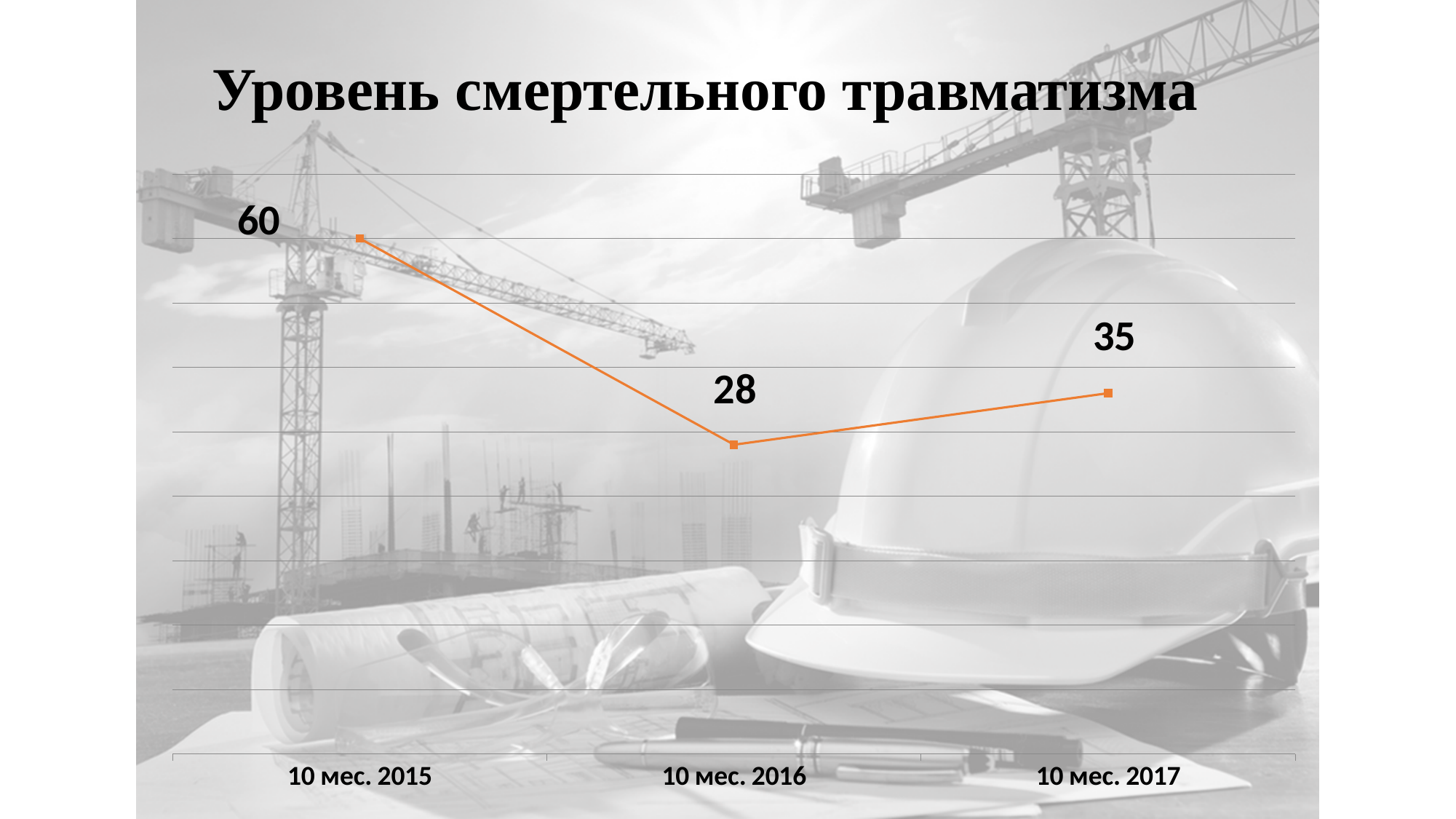
Which is larger, the value for 10 мес. 2016 or 10 мес. 2017? 10 мес. 2017 Does the value rise or fall from 10 мес. 2015 to 10 мес. 2016? fall What is the value for 10 мес. 2015? 60 What kind of chart is shown on the slide? line chart How many data points are plotted on the chart? 3 What is the title of the chart? Уровень смертельного травматизма What is the value for 10 мес. 2017? 35 Which period has the lowest value? 10 мес. 2016 What is the difference between the values for 10 мес. 2015 and 10 мес. 2016? 32 What is the difference between the values for 10 мес. 2017 and 10 мес. 2016? 7 What is the value for 10 мес. 2016? 28 Which period has the highest value? 10 мес. 2015